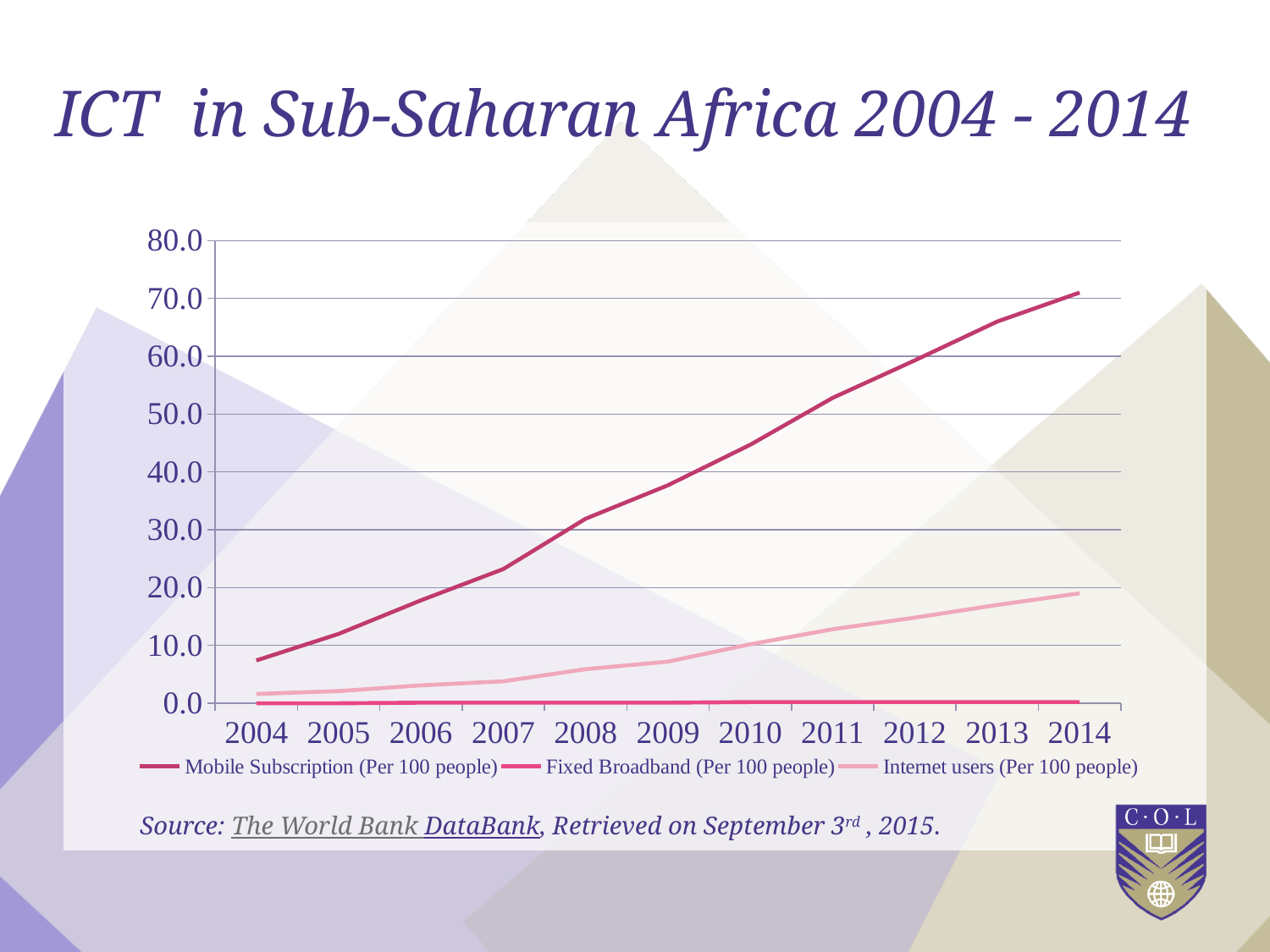
Does the Mobile Subscription (Per 100 people) line rise or fall from 2004 to 2014? rise How many series does the legend list? 3 Is the value for Mobile Subscription (Per 100 people) in 2012 greater or less than 50? greater How many years are plotted along the x axis? 11 In 2014, which is larger: Internet users (Per 100 people) or Fixed Broadband (Per 100 people)? Internet users (Per 100 people) Is the value for Mobile Subscription (Per 100 people) in 2004 greater or less than 10? less What is the title of the slide containing the chart? ICT in Sub-Saharan Africa 2004 - 2014 Which series has the lowest values across the whole period? Fixed Broadband (Per 100 people) Is the value for Mobile Subscription (Per 100 people) in 2014 greater or less than 60? greater Which series has the highest value in 2014? Mobile Subscription (Per 100 people) What kind of chart is shown on the slide? line chart